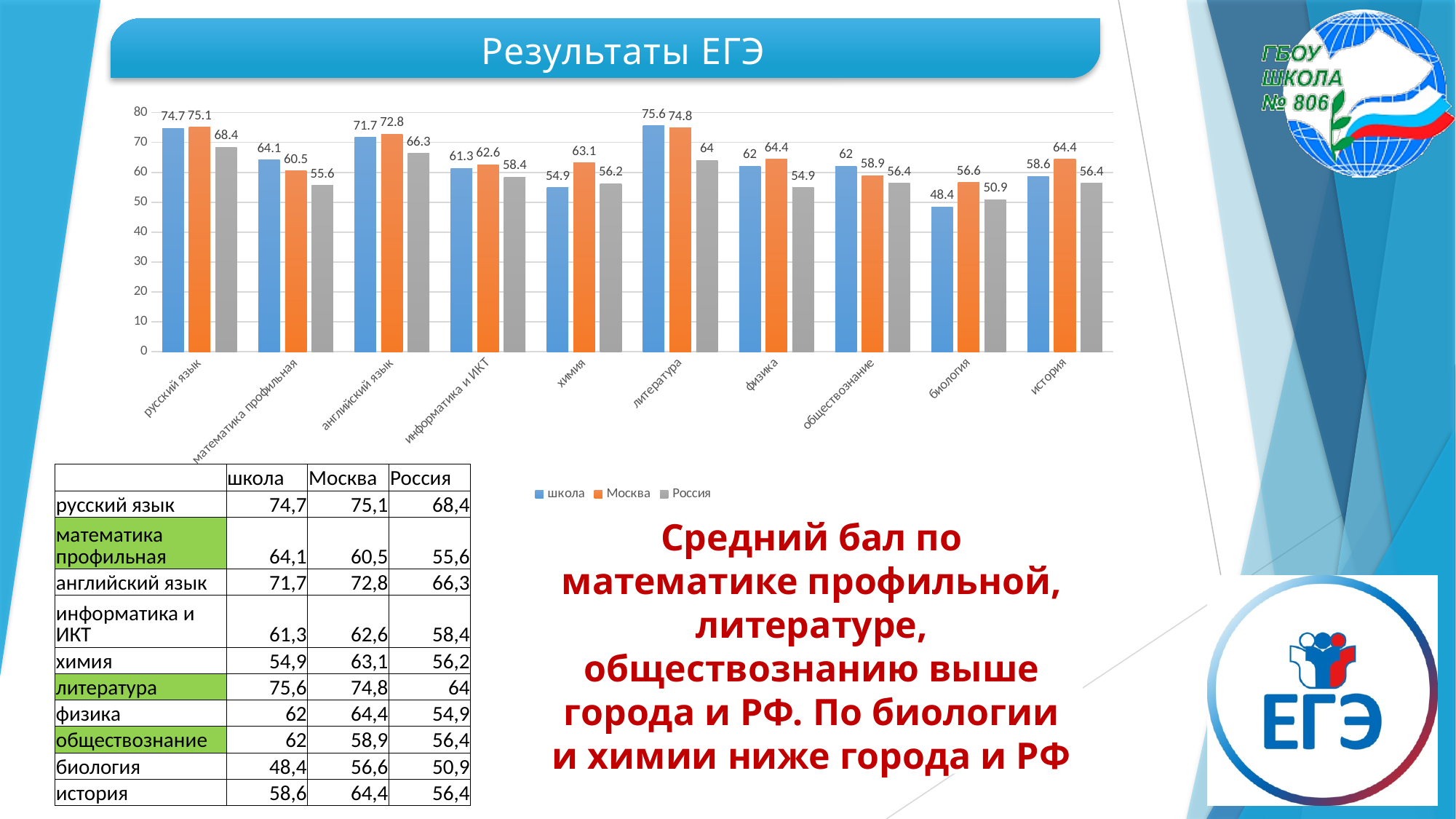
What is the title of the slide containing the chart? Результаты ЕГЭ How many categories are shown on the x axis? 10 What is the value for Москва in химия? 63.1 What kind of chart is shown on the slide? bar chart Is the value for Россия in физика greater or less than 60? less How many series does the legend list? 3 What is the value for Россия in биология? 50.9 Which category has the lowest value for the школа series? биология Which is larger in история: the школа value or the Москва value? Москва What is the value for школа in русский язык? 74.7 What is the difference between the школа and Москва values in математика профильная? 3.6 Which category has the highest value for the школа series? литература